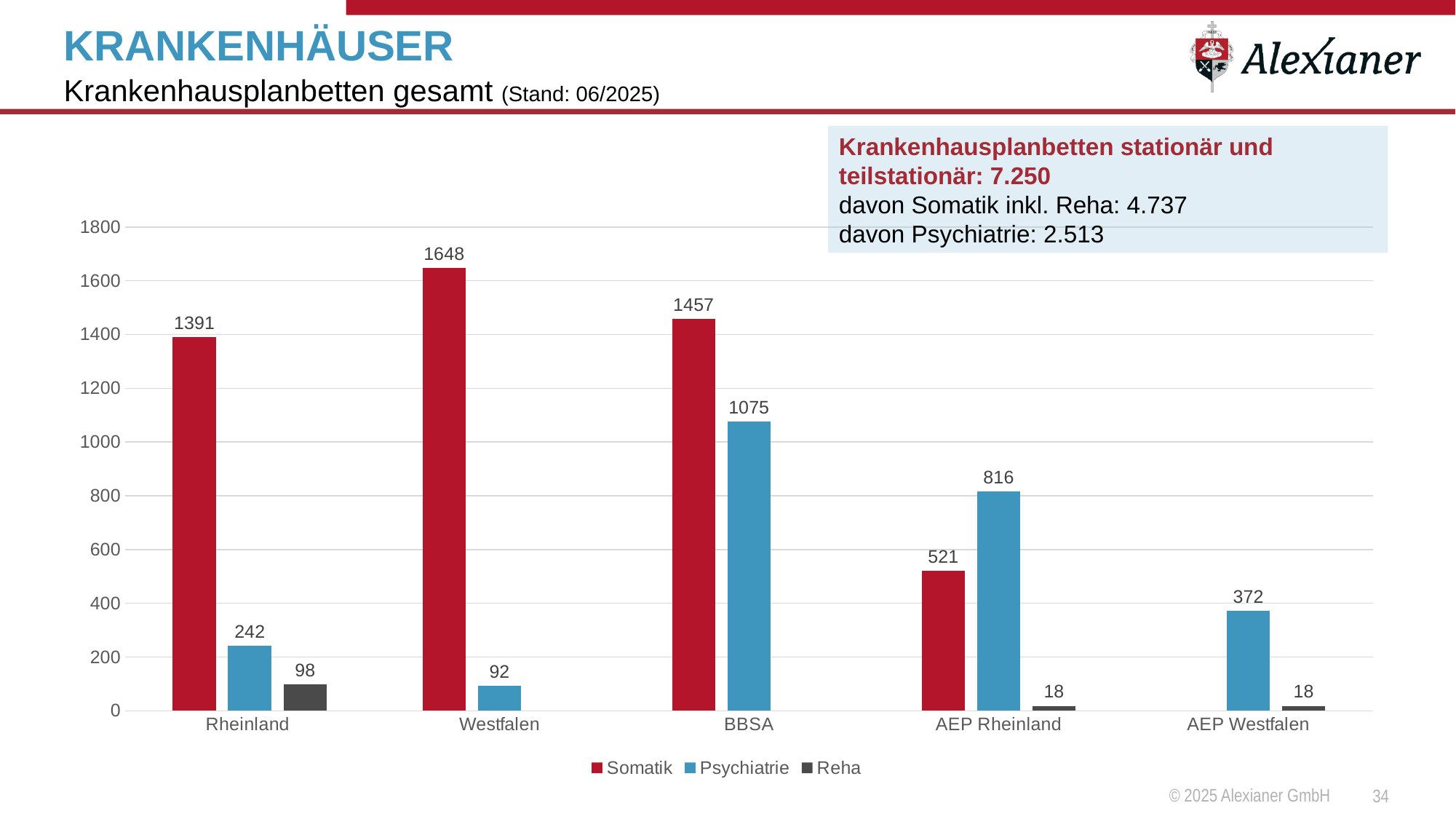
How many categories are shown on the x axis? 5 What is the Psychiatrie value for BBSA? 1075 How many series does the legend list? 3 What is the Reha value for Rheinland? 98 What is the difference between the Somatik values for Westfalen and Rheinland? 257 What is the Somatik value for Westfalen? 1648 Which category has the lowest Psychiatrie value? Westfalen Which category has the highest Somatik value? Westfalen Which is larger, the Psychiatrie value for AEP Rheinland or the Somatik value for AEP Rheinland? Psychiatrie What kind of chart is shown on the slide? Bar chart What is the Reha value for AEP Westfalen? 18 Which series is shown in blue in the legend? Psychiatrie